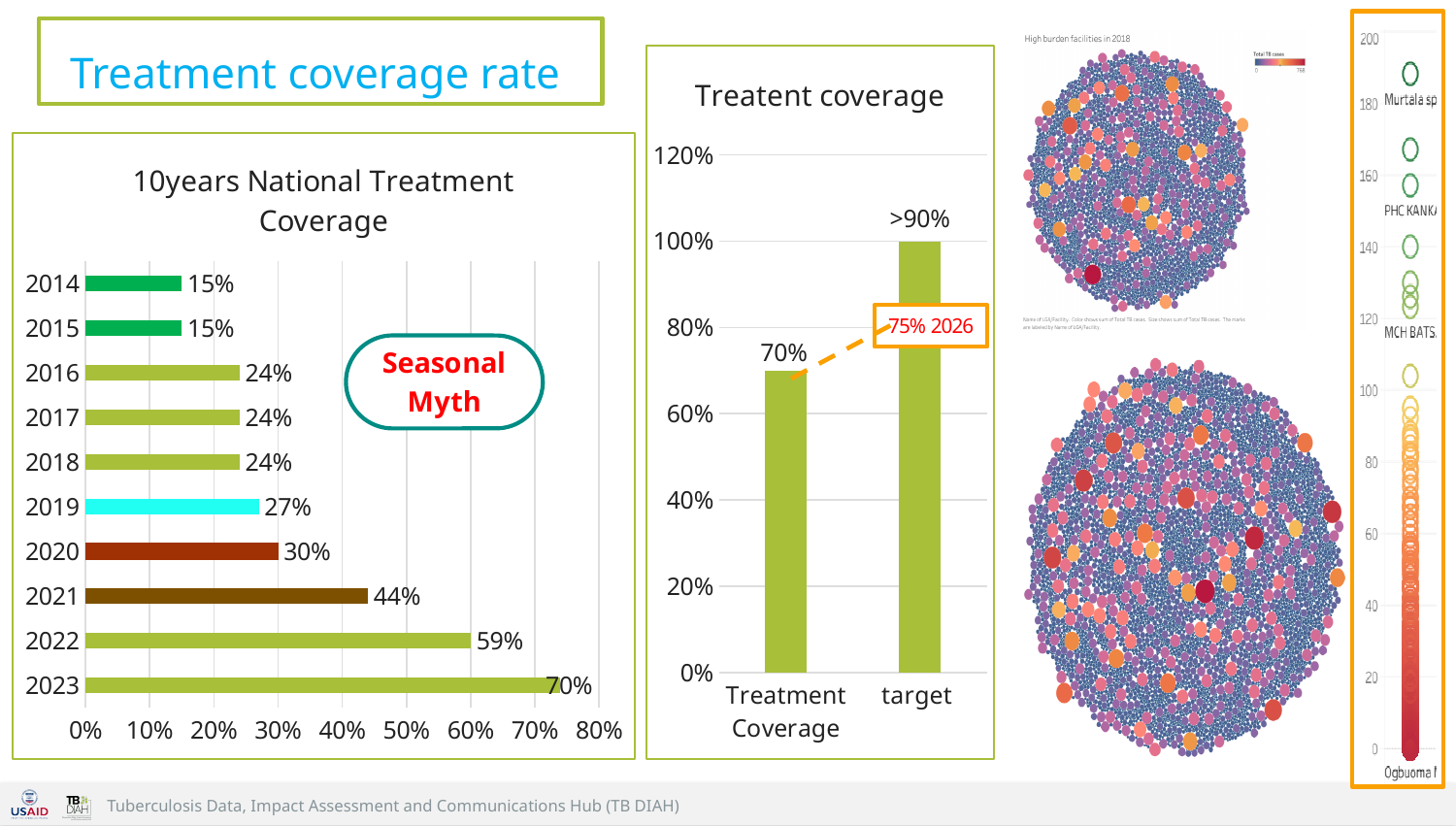
In the '10years National Treatment Coverage' chart, what is the difference between the values for 2023 and 2021? 26% In the '10years National Treatment Coverage' chart, do the values generally rise or fall from 2014 to 2023? Rise What kind of chart is the '10years National Treatment Coverage' chart? Bar chart What text appears in the oval callout on the '10years National Treatment Coverage' chart? Seasonal Myth In the '10years National Treatment Coverage' chart, what is the value for 2019? 27% In the 'Treatent coverage' chart, what label is shown above the target bar? >90% In the 'Treatent coverage' chart, is the value for Treatment Coverage greater or less than 80%? less How many years are shown in the '10years National Treatment Coverage' chart? 10 In the '10years National Treatment Coverage' chart, which year has the highest value? 2023 In the '10years National Treatment Coverage' chart, which is larger, the value for 2020 or the value for 2018? 2020 In the 'Treatent coverage' chart, what is the value labelled for Treatment Coverage? 70% In the '10years National Treatment Coverage' chart, what is the value for 2022? 59%